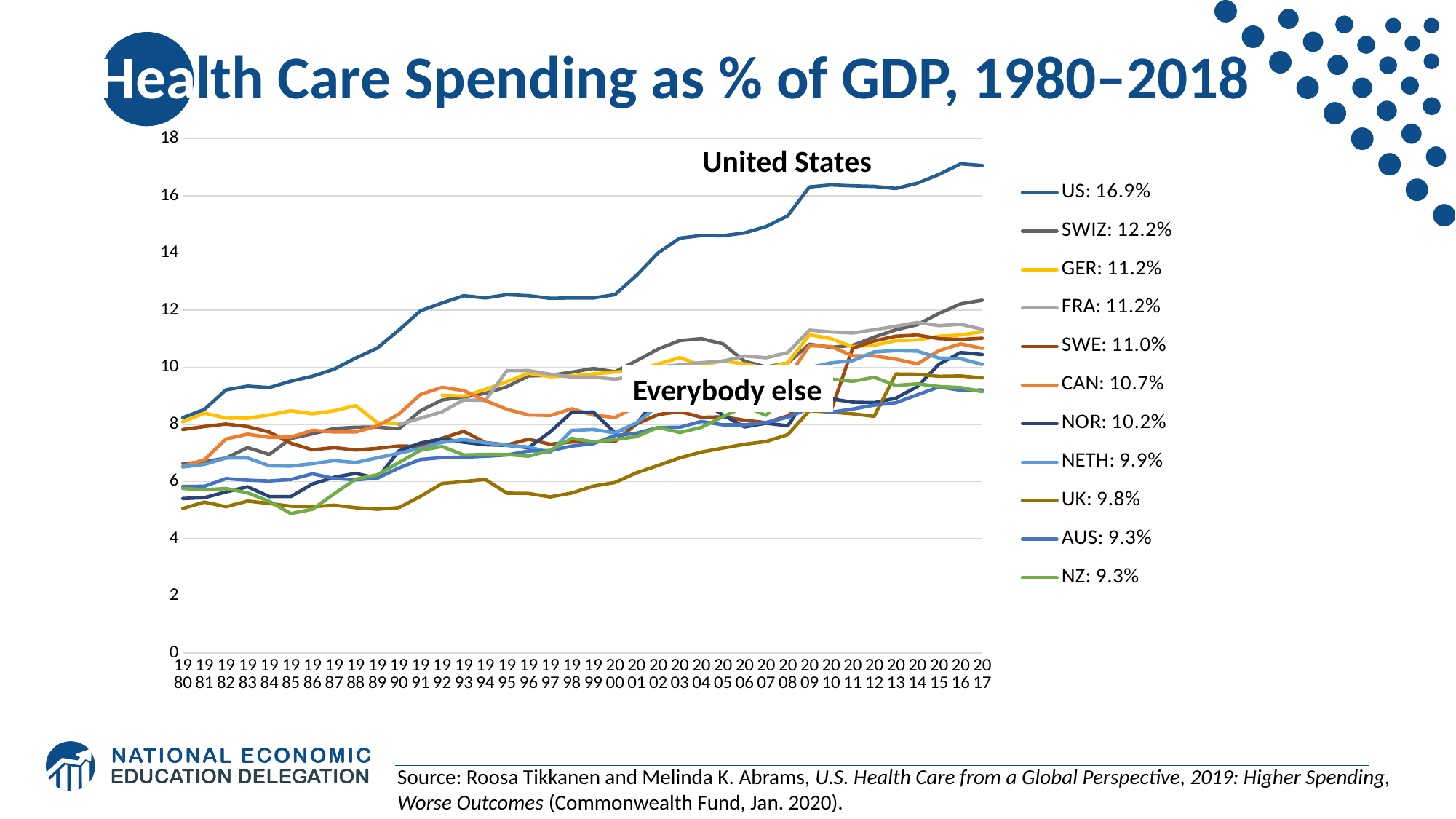
What value does the legend give for US? 16.9% What value does the legend give for CAN? 10.7% Is the value for the US line in 2000 greater or less than 12? greater How many series does the legend list? 11 What is the difference between the legend values for US and SWIZ? 4.7 percentage points What is the title of the chart? Health Care Spending as % of GDP, 1980–2018 Which has a higher legend value, NOR or NETH? NOR What kind of chart is shown on the slide? line chart Which country has the highest health care spending as % of GDP according to the legend? US What value does the legend give for SWIZ? 12.2% What value does the legend give for UK? 9.8% Does the US line generally rise or fall from 1980 to 2017? rise